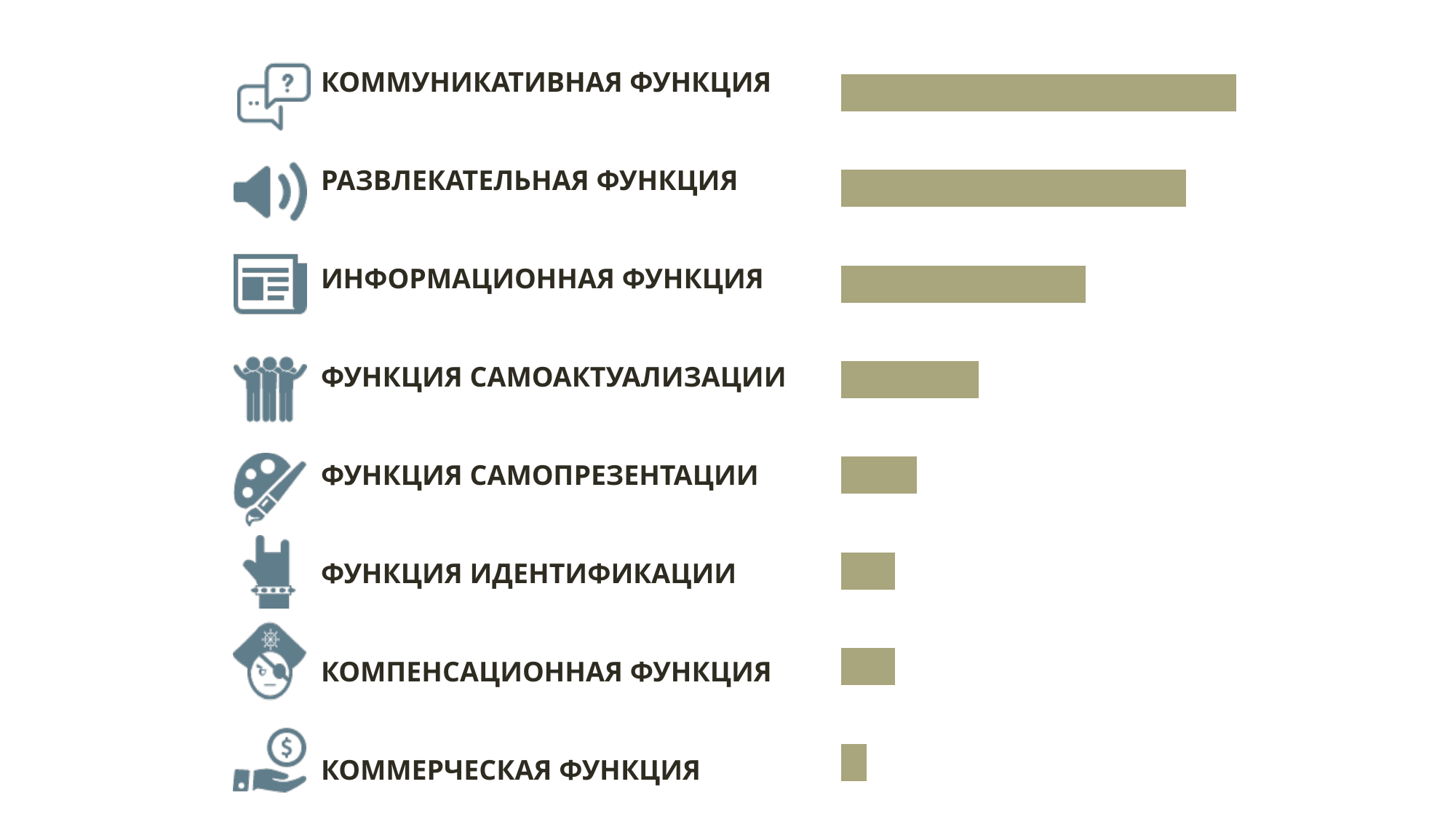
Which bar is longer: ФУНКЦИЯ ИДЕНТИФИКАЦИИ or КОММЕРЧЕСКАЯ ФУНКЦИЯ? ФУНКЦИЯ ИДЕНТИФИКАЦИИ Which function has the longest bar? КОММУНИКАТИВНАЯ ФУНКЦИЯ Which function has the shortest bar? КОММЕРЧЕСКАЯ ФУНКЦИЯ What kind of chart is shown on the slide? bar chart How many categories (functions) are plotted in the bar chart? 8 Which bar is longer: ФУНКЦИЯ САМОПРЕЗЕНТАЦИИ or РАЗВЛЕКАТЕЛЬНАЯ ФУНКЦИЯ? РАЗВЛЕКАТЕЛЬНАЯ ФУНКЦИЯ Which function is listed second from the top in the chart? РАЗВЛЕКАТЕЛЬНАЯ ФУНКЦИЯ Do the bar lengths increase or decrease going from the top category to the bottom category? decrease Which bar is longer: ИНФОРМАЦИОННАЯ ФУНКЦИЯ or ФУНКЦИЯ САМОАКТУАЛИЗАЦИИ? ИНФОРМАЦИОННАЯ ФУНКЦИЯ Are the bars in the chart oriented horizontally or vertically? horizontally